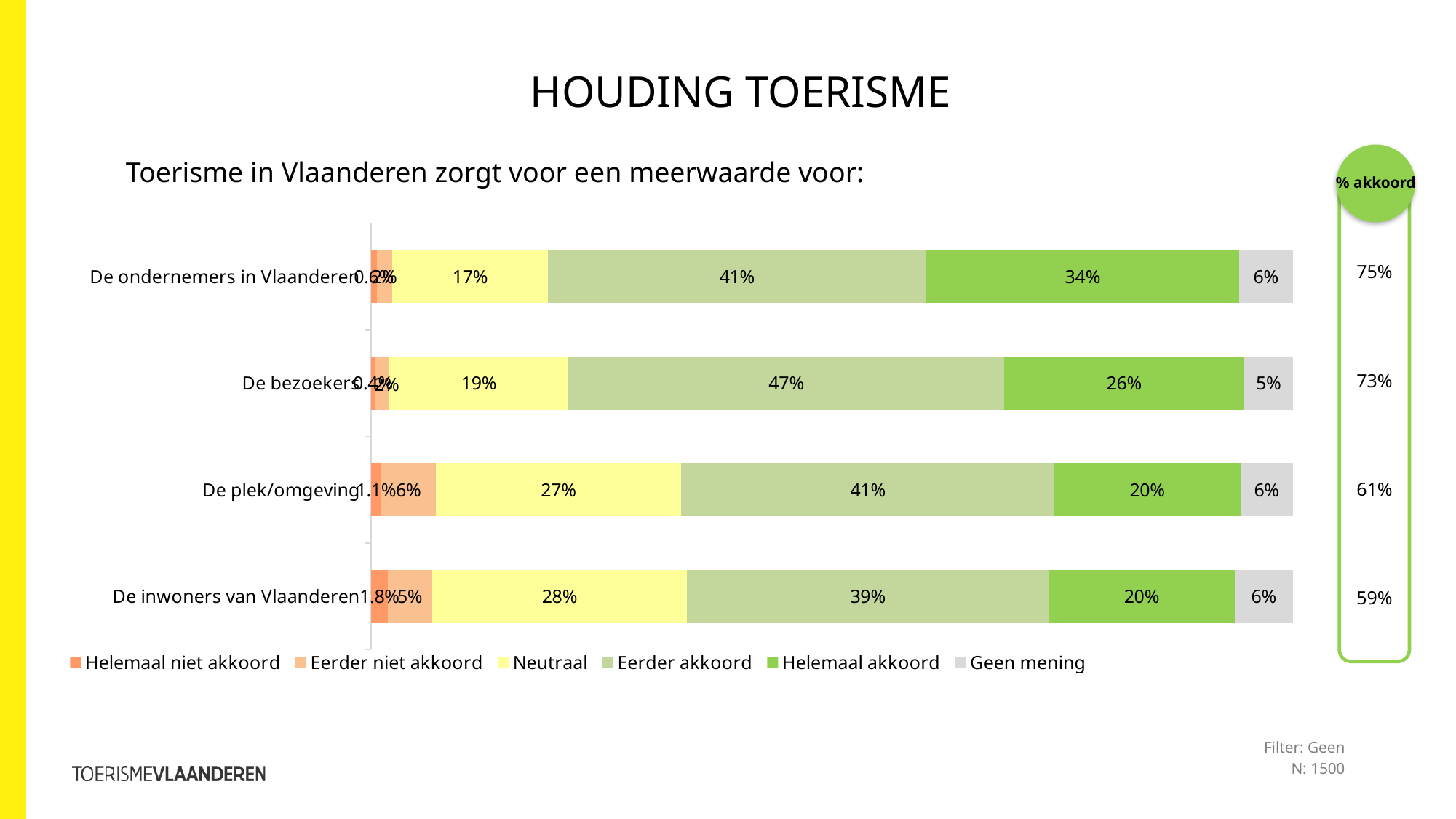
What is the 'Eerder akkoord' value for 'De bezoekers'? 47% What is the 'Geen mening' value for 'De bezoekers'? 5% Which category has the highest 'Helemaal akkoord' value? De ondernemers in Vlaanderen How many series does the legend list? 6 Which category has the lowest 'Neutraal' value? De ondernemers in Vlaanderen What '% akkoord' value is shown for 'De plek/omgeving' in the column on the right? 61% What is the 'Helemaal akkoord' value for 'De ondernemers in Vlaanderen'? 34% How many categories are plotted on the chart? 4 Which is larger: the 'Helemaal akkoord' value for 'De bezoekers' or for 'De plek/omgeving'? De bezoekers What is the 'Neutraal' value for 'De inwoners van Vlaanderen'? 28% What is the difference between the 'Eerder akkoord' values for 'De bezoekers' and 'De inwoners van Vlaanderen'? 8% What kind of chart is shown on the slide? Stacked bar chart